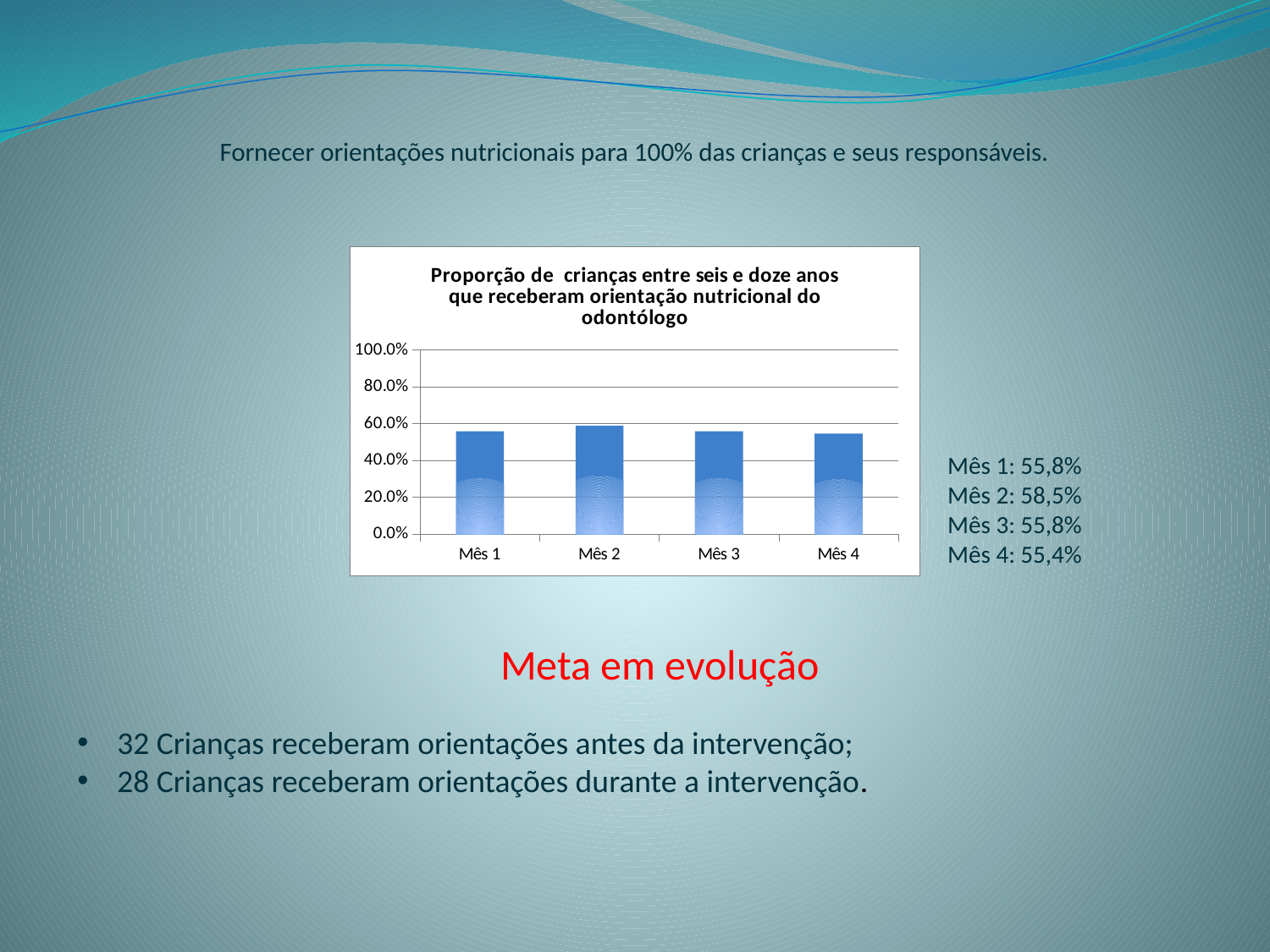
What type of chart is shown on the slide? bar chart Is the value for Mês 2 greater or less than 60%? less What is the value for Mês 4? 55,4% Is the value for Mês 4 greater or less than 40%? greater How many months (categories) are plotted in the chart? 4 Which month has the highest proportion? Mês 2 Which month has the lowest proportion? Mês 4 What is the difference between the values for Mês 2 and Mês 1? 2,7% What is the value for Mês 1? 55,8% Which is larger, the value for Mês 2 or the value for Mês 3? Mês 2 What is the value for Mês 2? 58,5% What is the title of the chart? Proporção de crianças entre seis e doze anos que receberam orientação nutricional do odontólogo